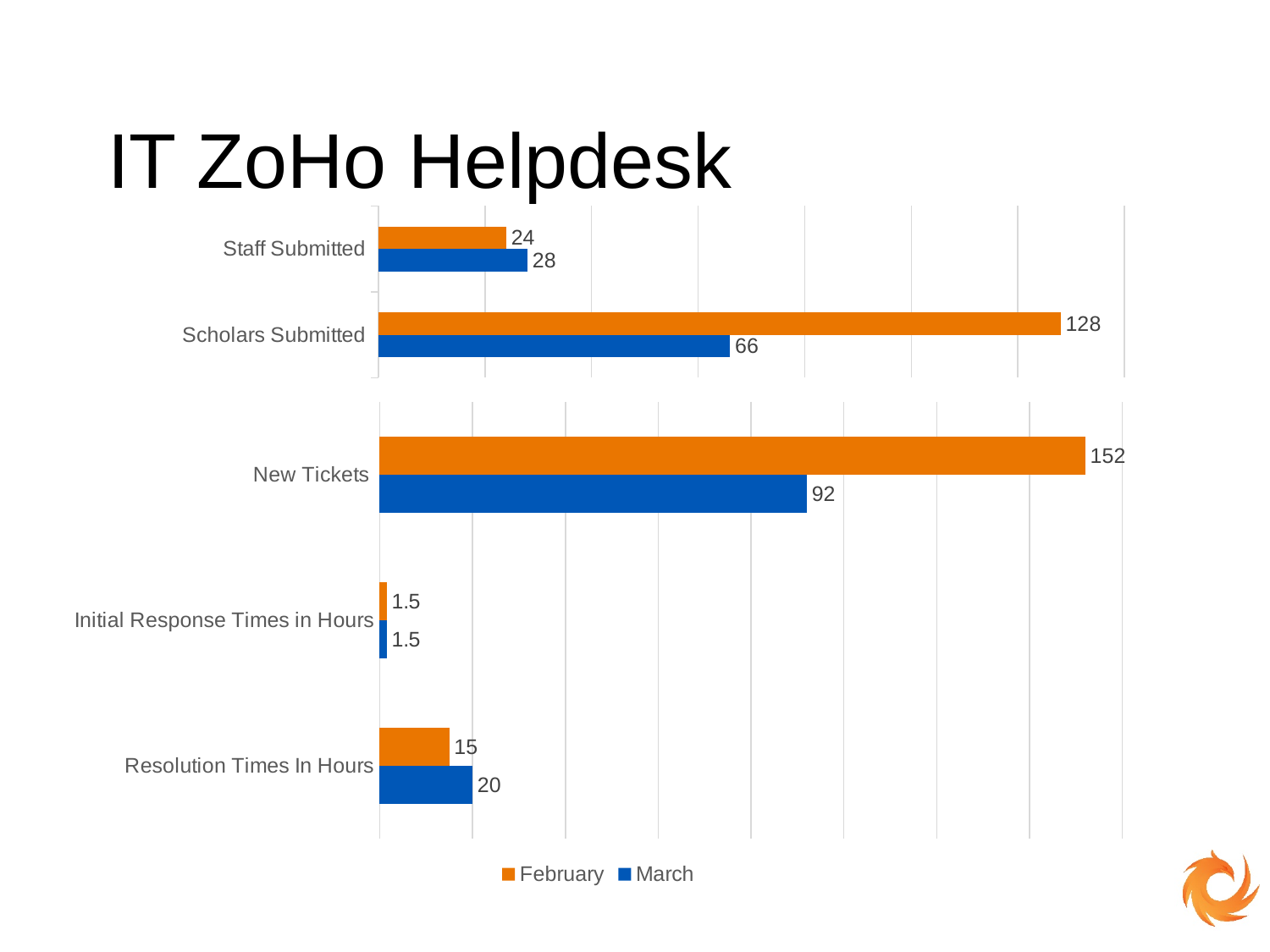
In the top chart, what is the February value for Scholars Submitted? 128 How many series does the legend at the bottom of the slide list? 2 In the top chart, which month has the larger value for Staff Submitted? March In the bottom chart, what is the February value for Resolution Times In Hours? 15 In the bottom chart, which category has the highest February value? New Tickets In the bottom chart, what is the difference between the February and March values for New Tickets? 60 In the top chart, what is the March value for Staff Submitted? 28 In the bottom chart, what is the March value for New Tickets? 92 What type of chart is the bottom chart? Bar chart How many categories are shown in the bottom chart? 3 In the bottom chart, which category has the lowest March value? Initial Response Times in Hours In the top chart, what is the difference between the February and March values for Scholars Submitted? 62